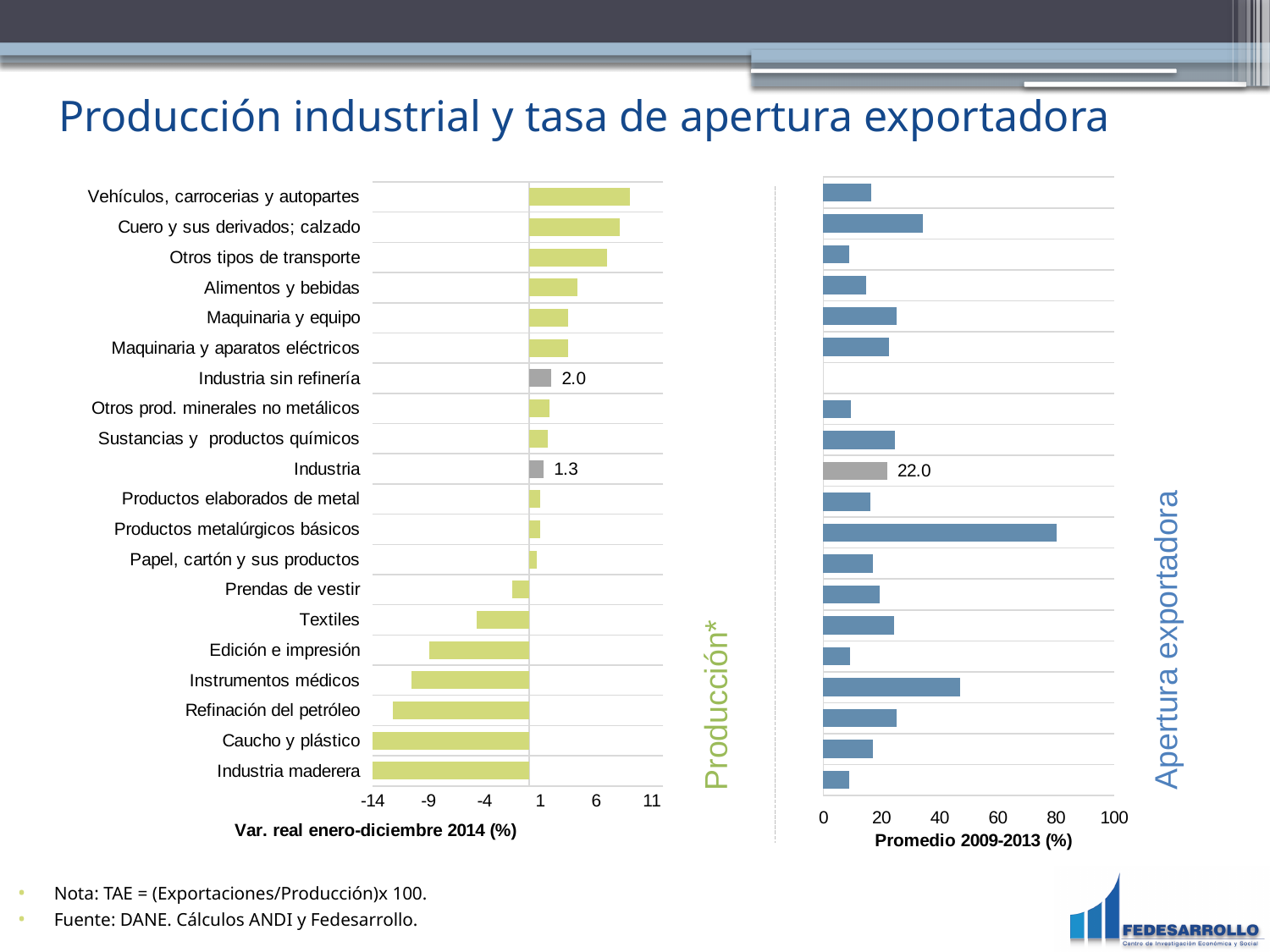
In the Apertura exportadora chart, is the value for Productos metalúrgicos básicos greater or less than 60? greater In the Producción chart, what is the value for Industria sin refinería? 2.0 In the Apertura exportadora chart, which is larger: the value for Cuero y sus derivados; calzado or the value for Vehículos, carrocerias y autopartes? Cuero y sus derivados; calzado In the Apertura exportadora chart, what is the value for Industria? 22.0 In the Producción chart, which category has the highest value? Vehículos, carrocerias y autopartes In the Producción chart, what is the difference between the values for Industria sin refinería and Industria? 0.7 In the Apertura exportadora chart, which category has the highest value? Productos metalúrgicos básicos How many categories are listed in the Producción chart? 20 In the Apertura exportadora chart, is the value for Instrumentos médicos greater or less than 40? greater What kind of chart is the Apertura exportadora chart? Bar chart In the Producción chart, is the value for Refinación del petróleo greater or less than -9? less In the Producción chart, what is the value for Industria? 1.3